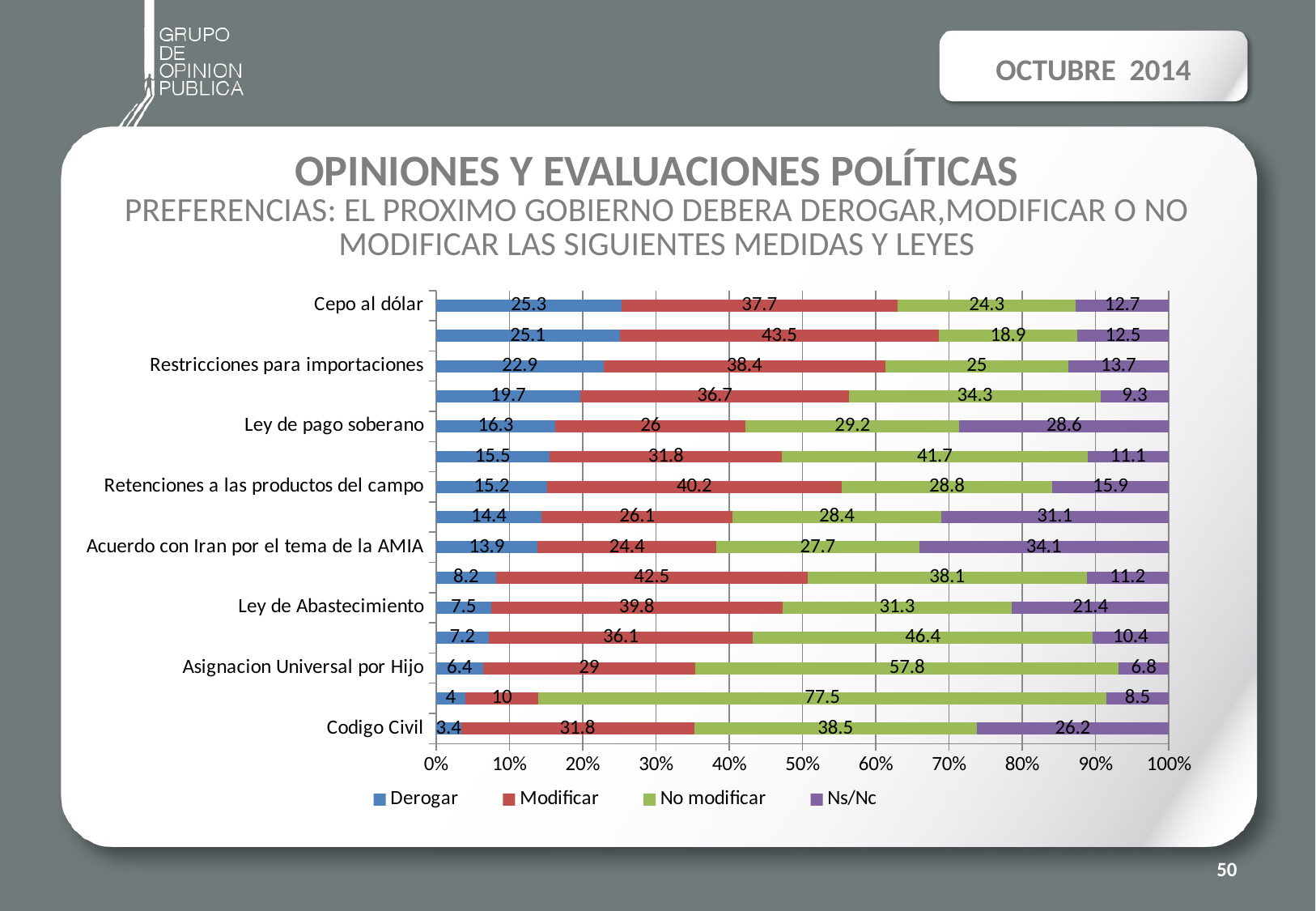
Which category has the lowest Derogar value? Codigo Civil What is the Ns/Nc value for Acuerdo con Iran por el tema de la AMIA? 34.1 Which category has the highest Ns/Nc value? Acuerdo con Iran por el tema de la AMIA What kind of chart is shown on the slide? Stacked bar chart What is the Modificar value for Retenciones a las productos del campo? 40.2 How many bars are plotted in the chart? 15 Which category has the highest Derogar value? Cepo al dólar What is the Derogar value for Cepo al dólar? 25.3 For Ley de Abastecimiento, which is larger: Modificar or No modificar? Modificar What is the No modificar value for Asignacion Universal por Hijo? 57.8 For Cepo al dólar, what is the difference between the Modificar and Derogar values? 12.4 How many series does the legend list? 4